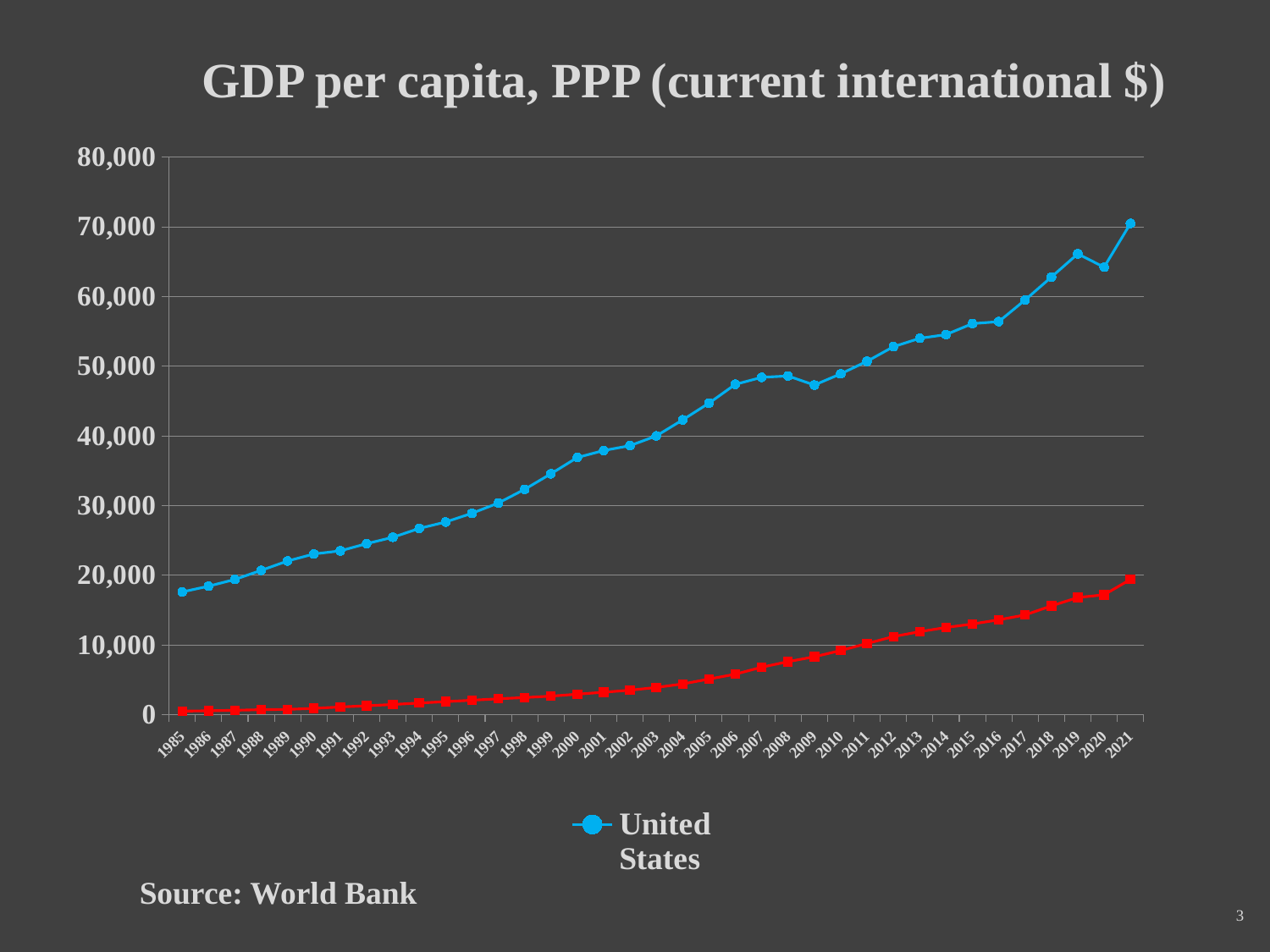
How many years are plotted along the x axis? 37 In which year is the United States value highest? 2021 What is the title of the chart? GDP per capita, PPP (current international $) Does the United States line rise or fall overall from 1985 to 2021? rise Is the United States value for 2009 greater or less than 50,000? less Is the United States value for 2000 greater or less than 40,000? less Is the United States value for 2019 greater or less than 60,000? greater In which year is the United States value lowest? 1985 What kind of chart is shown on the slide? line chart Which year has the larger United States value, 2019 or 2020? 2019 How many series does the chart's legend list? 1